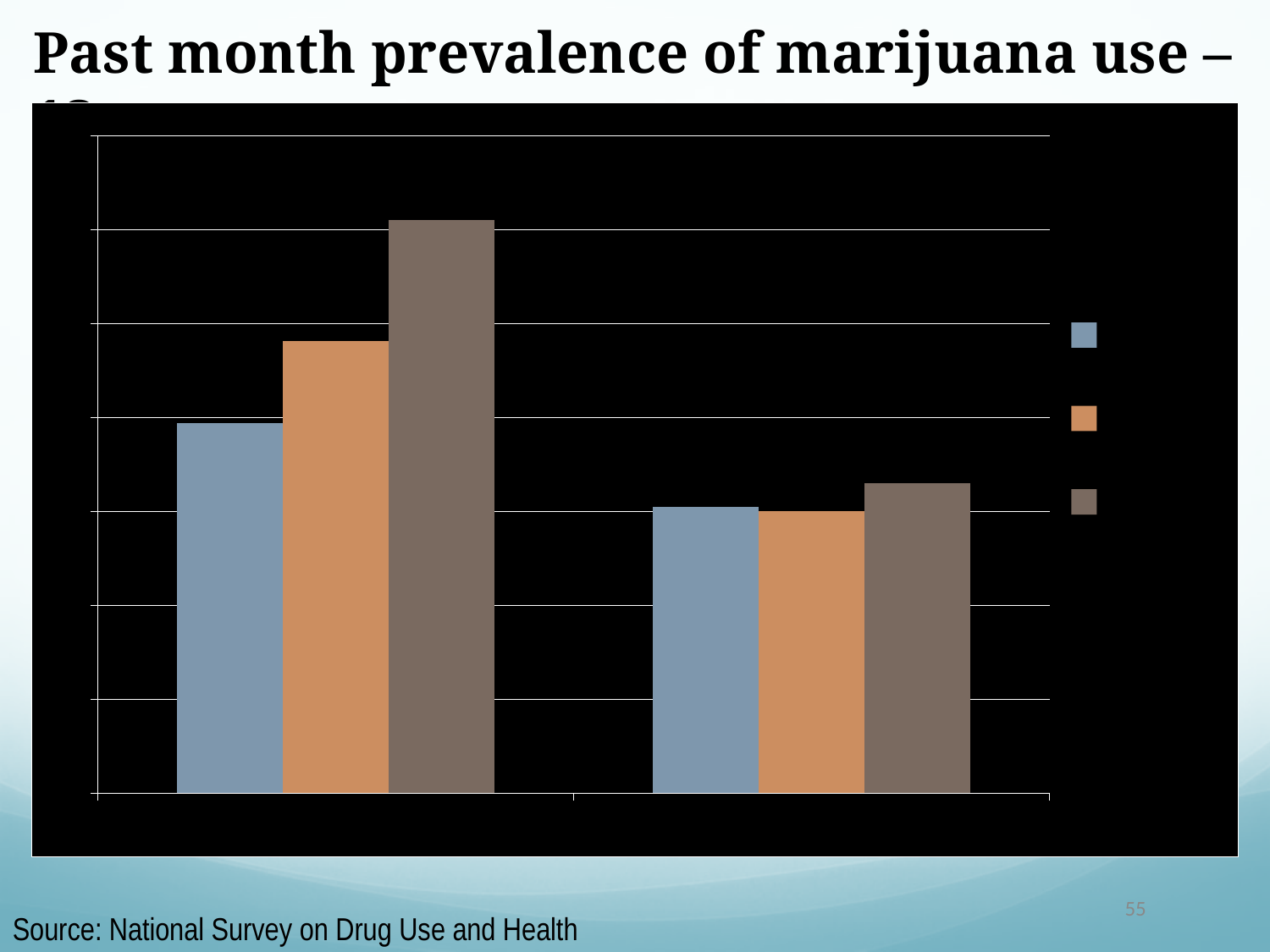
How many bars are plotted in total? 6 How many series does the legend list? 3 In the left group of bars, which colour bar is the shortest? blue Do the bars for each series rise or fall from the left group to the right group? fall Which bar is the tallest on the whole chart? the brown bar in the left group How many groups of bars are plotted along the x axis? 2 What source is cited at the bottom of the slide for the chart data? National Survey on Drug Use and Health Is the brown bar taller in the left group or in the right group? left group In the right group of bars, which colour bar is the tallest? brown What kind of chart is shown on the slide? bar chart In the left group of bars, which colour bar is the tallest? brown In the left group, is the orange bar or the blue bar taller? orange